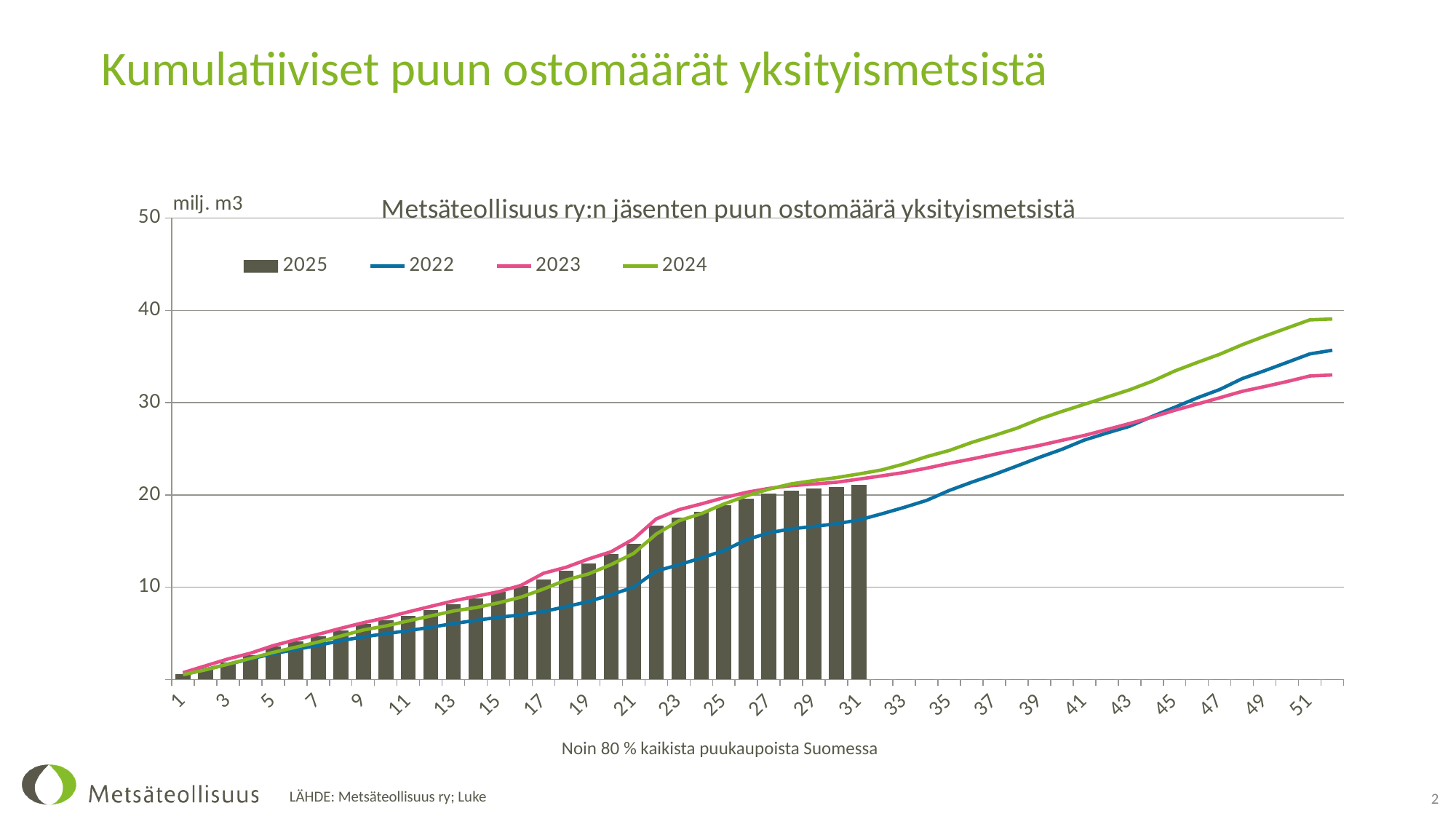
Which series has the highest value at the right end of the chart (week 51)? 2024 Is the value of the 2024 line at week 51 greater or less than 30? greater Is the value of the 2022 line at week 31 greater or less than 20? less How many series does the chart legend list? 4 At week 31, which is higher: the 2022 line or the 2023 line? 2023 Is the value of the 2023 line at week 41 greater or less than 30? less Do the values of the 2024 line rise or fall along the x axis? rise What is the title of the chart? Metsäteollisuus ry:n jäsenten puun ostomäärä yksityismetsistä Which series is plotted as bars rather than a line? 2025 At week 51, which is higher: the 2022 line or the 2023 line? 2022 Which series has the lowest value at the right end of the chart (week 51)? 2023 What kind of chart is shown on the slide? A combined bar and line chart